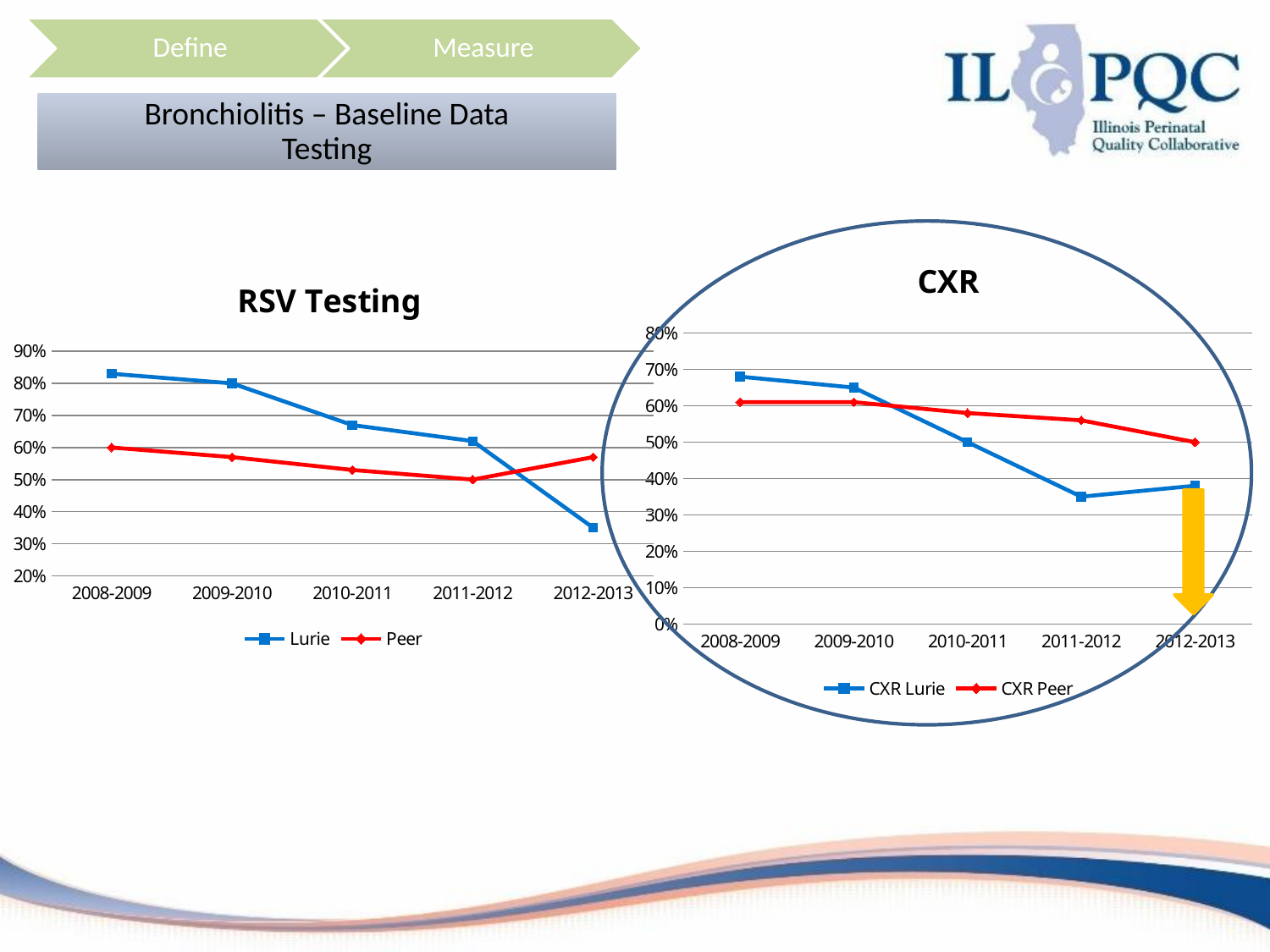
In the CXR chart, is the CXR Lurie value for 2011-2012 greater or less than 40%? less In the CXR chart, what is the CXR Lurie value for 2010-2011? 50% In the CXR chart, does the CXR Peer series generally rise or fall from 2008-2009 to 2012-2013? fall In the CXR chart, which period has the lowest CXR Lurie value? 2011-2012 How many series does the legend of the CXR chart list? 2 In the RSV Testing chart, what is the Lurie value for 2009-2010? 80% In the RSV Testing chart, which period has the highest Lurie value? 2008-2009 What kind of chart is the RSV Testing chart? line chart In the RSV Testing chart, what is the Peer value for 2008-2009? 60% In the RSV Testing chart, which series has the larger value for 2012-2013, Lurie or Peer? Peer In the RSV Testing chart, is the Lurie value for 2012-2013 greater or less than 40%? less How many time periods are shown on the x axis of the RSV Testing chart? 5